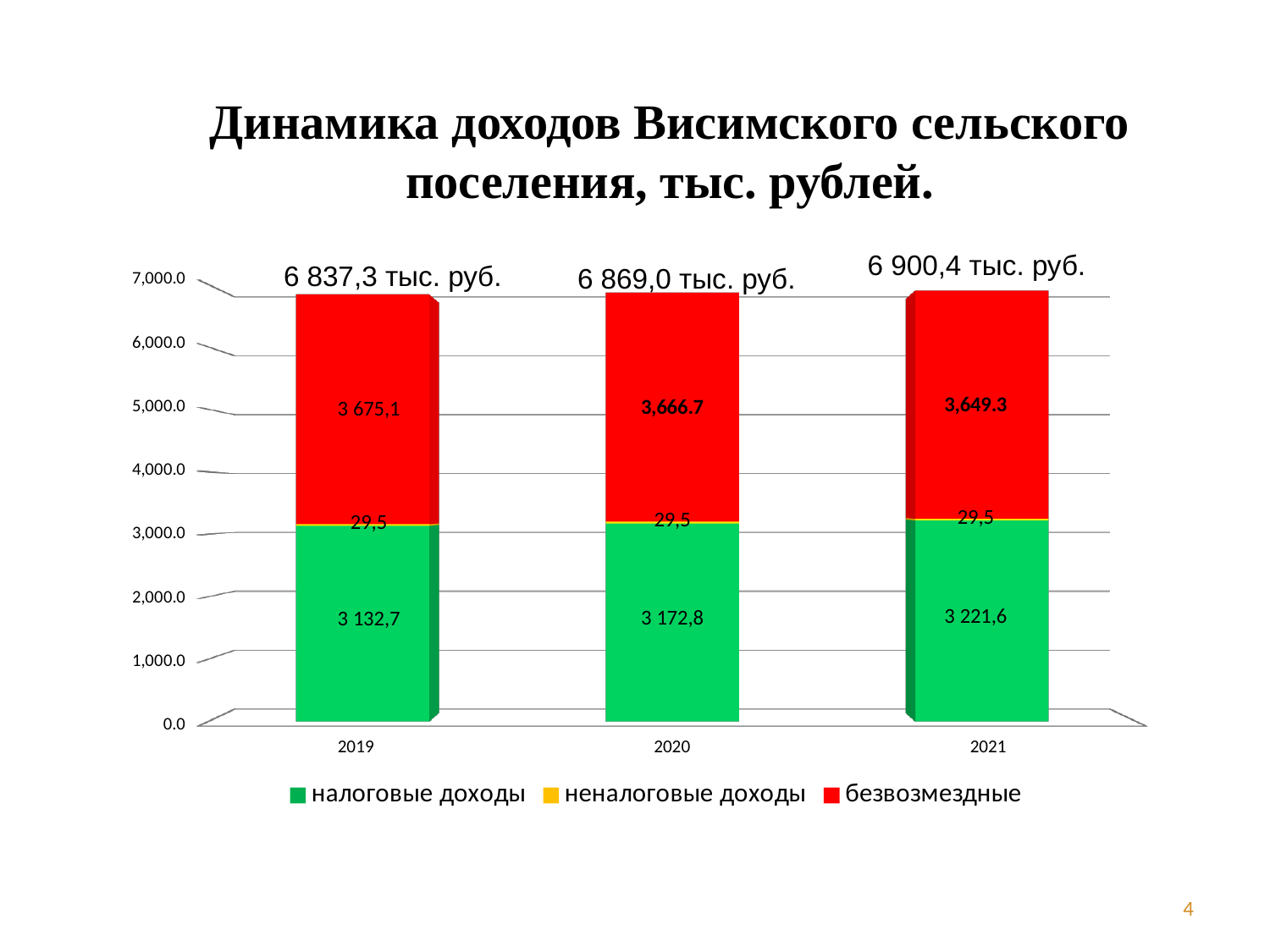
How many years are shown on the x axis? 3 Do the values of налоговые доходы rise or fall from 2019 to 2021? rise What is the value of неналоговые доходы for 2020? 29,5 What is the value of безвозмездные for 2021? 3,649.3 In which year is the value of налоговые доходы the highest? 2021 What is the total income shown above the bar for 2021? 6 900,4 тыс. руб. What is the total income shown above the bar for 2020? 6 869,0 тыс. руб. What type of chart is shown on the slide? stacked bar chart What is the value of налоговые доходы for 2019? 3 132,7 Which is larger: налоговые доходы in 2020 or налоговые доходы in 2019? 2020 In which year is the value of безвозмездные the lowest? 2021 How many series does the legend list? 3